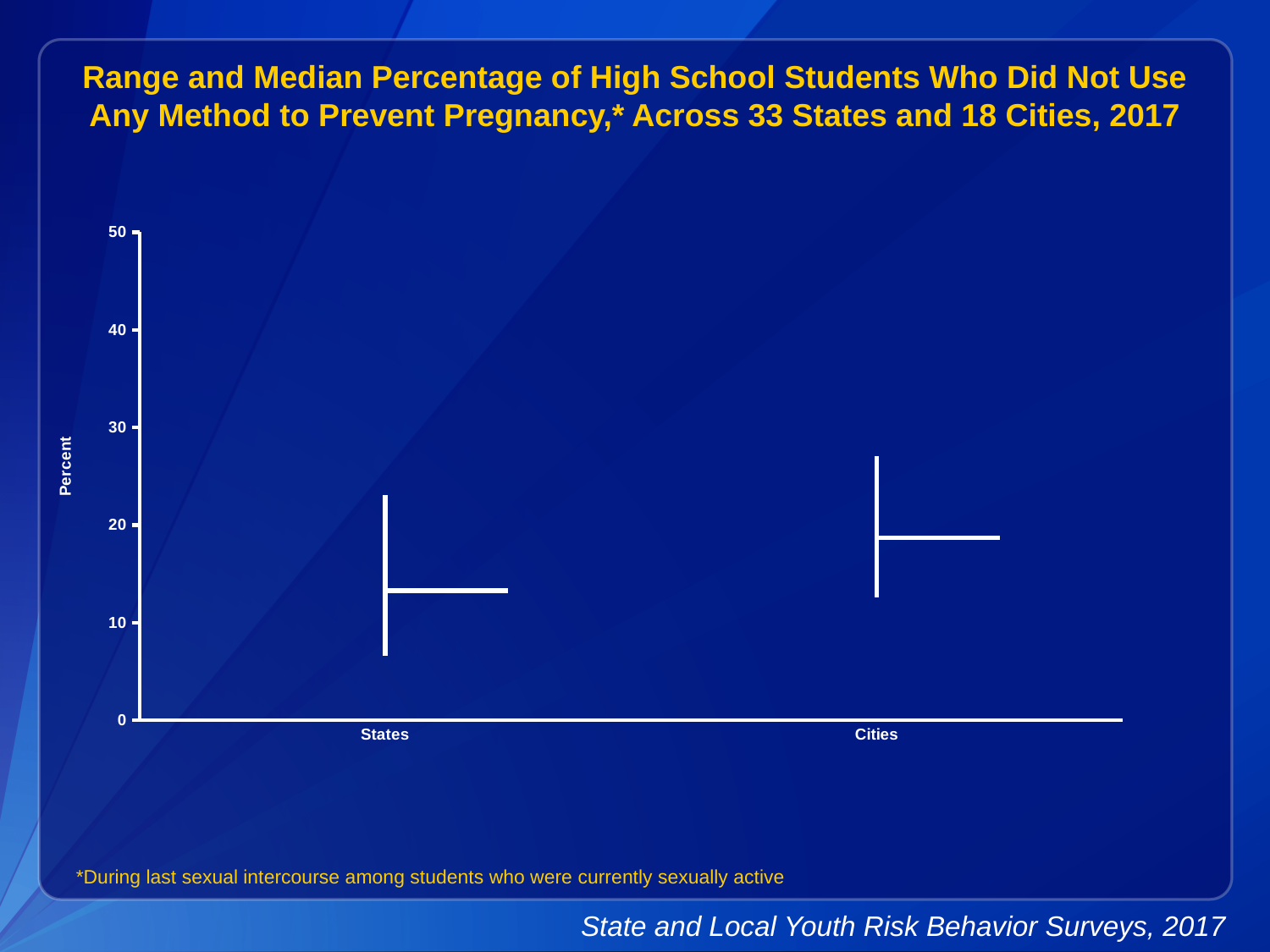
How many categories are shown on the x axis of the chart? 2 Which category has the higher maximum value in its range? Cities Is the top of the range for States greater or less than 30? less Is the top of the range for Cities greater or less than 20? greater Is the median value for States greater or less than 20? less What are the two categories shown on the x axis? States and Cities What is the label on the y axis of the chart? Percent Which category has the lower minimum value in its range? States Which category has the higher median percentage, States or Cities? Cities